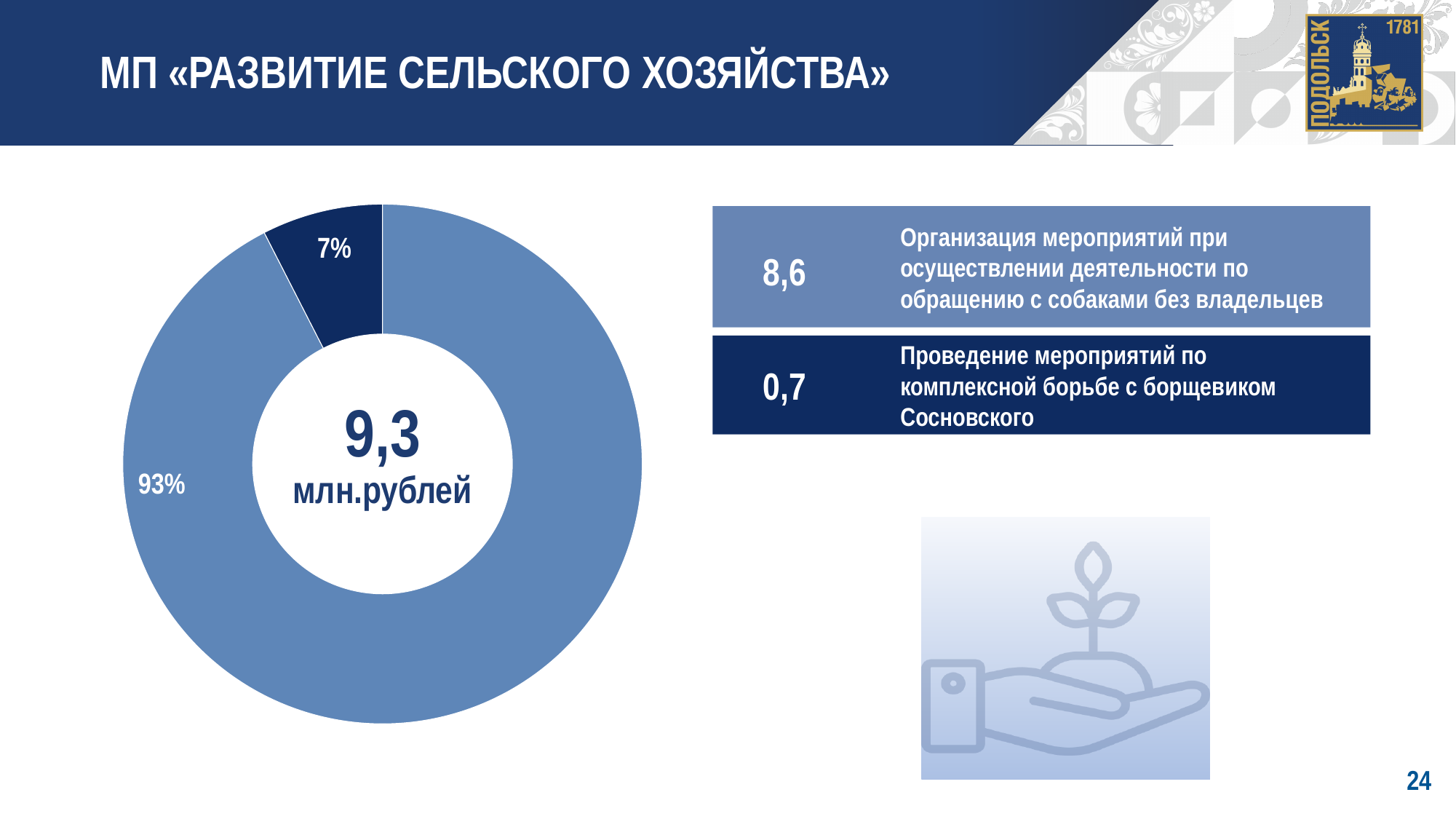
What total value is shown in the centre of the donut chart? 9,3 млн.рублей What share of the donut chart does the smaller slice represent? 7% What share of the donut chart does the larger slice represent? 93% What is the difference between the 93% slice and the 7% slice, in percentage points? 86 What kind of chart is shown on the slide? Pie (donut) chart What value is shown for «Организация мероприятий при осуществлении деятельности по обращению с собаками без владельцев»? 8,6 How many slices does the donut chart have? 2 What value is shown for «Проведение мероприятий по комплексной борьбе с борщевиком Сосновского»? 0,7 Which item has the lowest value on the slide? Проведение мероприятий по комплексной борьбе с борщевиком Сосновского Which item has the highest value: the dog-related activities (собаки без владельцев) or the hogweed control (борщевик Сосновского)? Организация мероприятий при осуществлении деятельности по обращению с собаками без владельцев What colour is the 7% slice of the donut chart? Dark blue What is the difference between the values 8,6 and 0,7 shown on the slide? 7,9